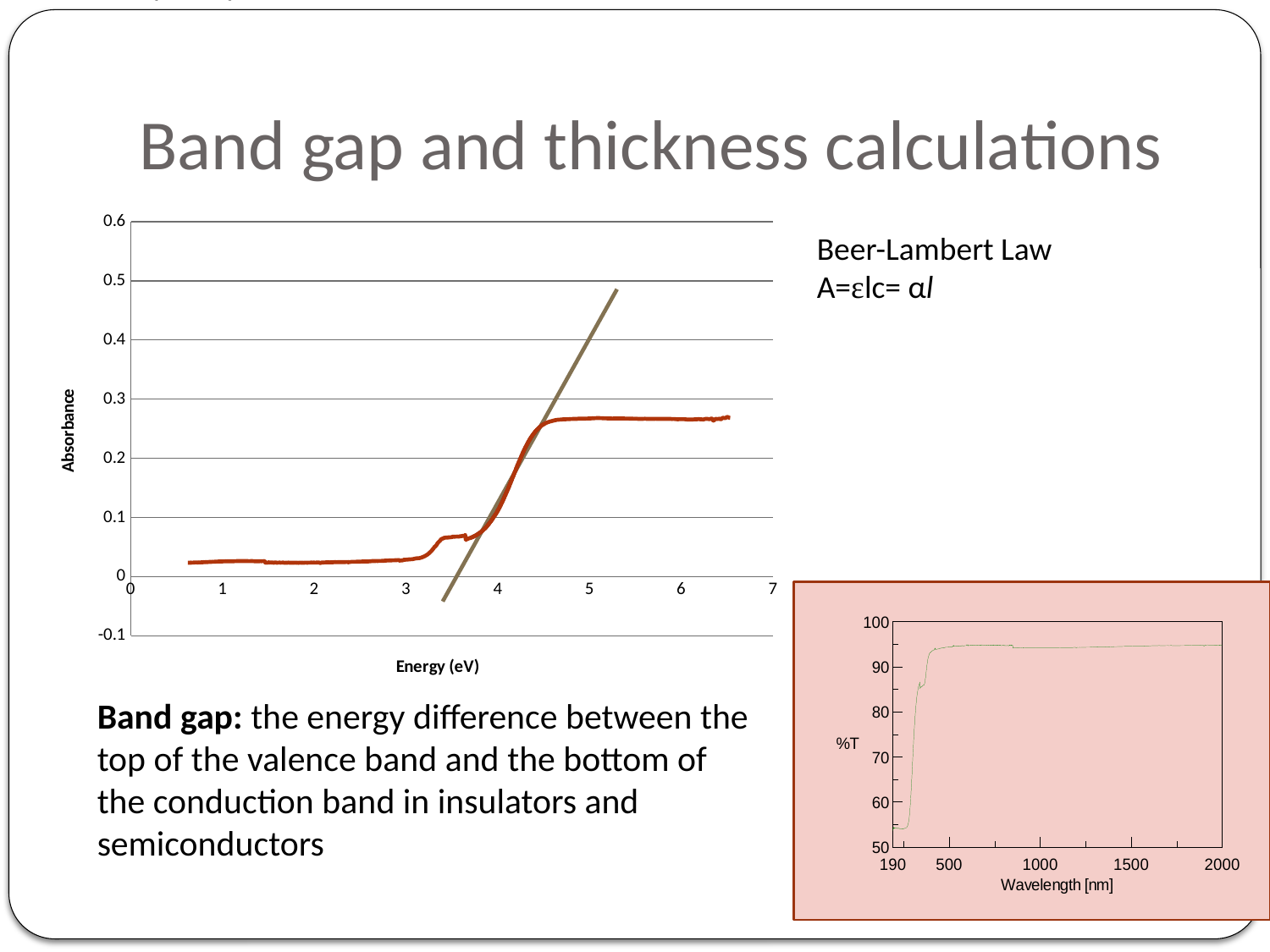
In the left chart, does the absorbance overall rise or fall as energy increases from 1 eV to 5 eV? rise In the bottom-right chart, does %T rise or fall as wavelength increases from 190 nm to 500 nm? rise In the bottom-right chart, is the %T at 190 nm greater or less than 60? less In the bottom-right chart, is the %T at 1000 nm greater or less than 90? greater In the left chart, what is the label of the x axis? Energy (eV) In the left chart, what is the highest value shown on the y axis? 0.6 In the left chart, is the absorbance at 6 eV greater or less than 0.2? greater How many charts are shown on the slide? 2 What type of chart is the large chart on the left of the slide? line chart In the left chart, what is the label of the y axis? Absorbance What type of chart is the small chart in the pink box at the bottom right? line chart